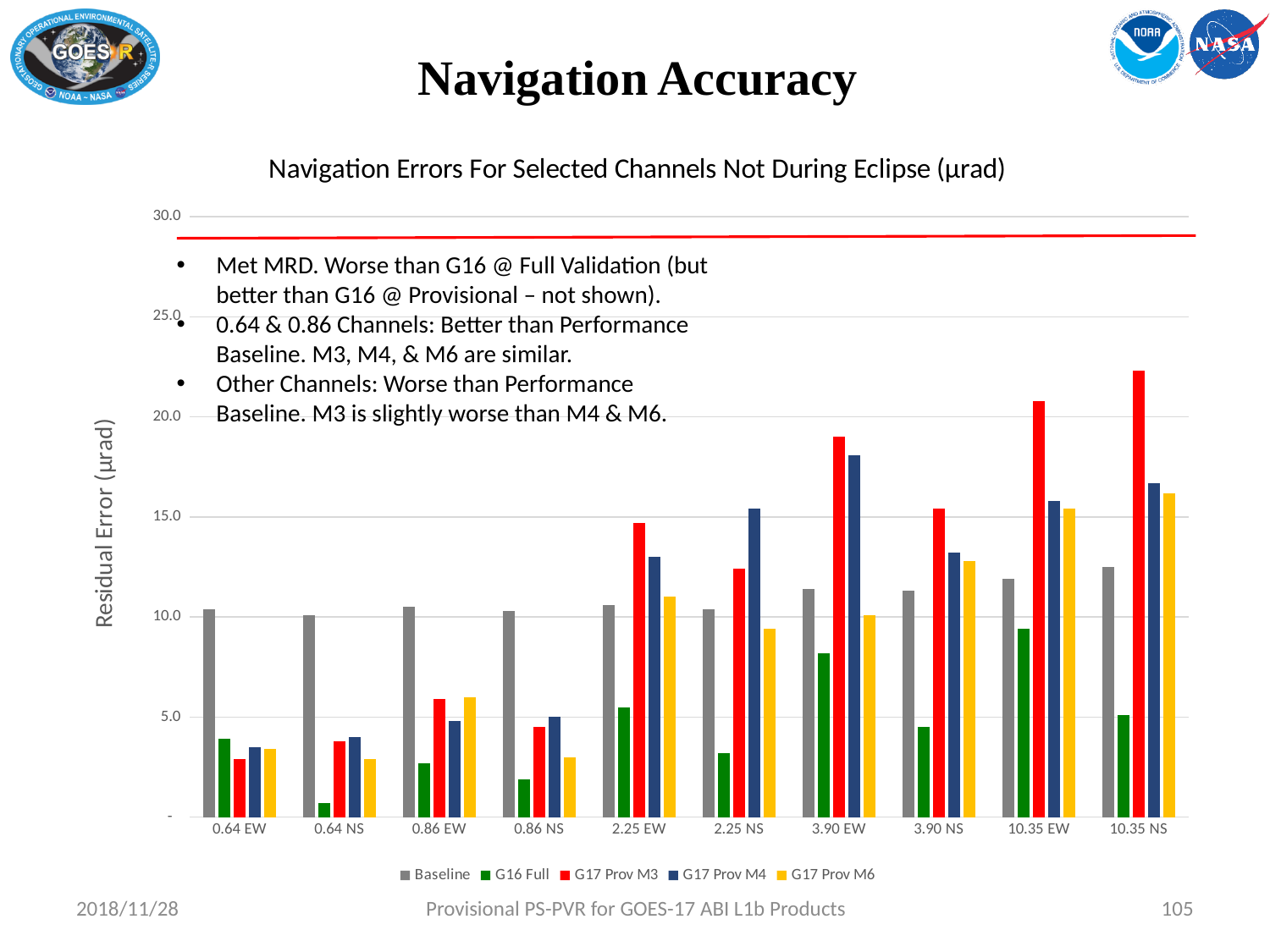
Which is larger for G17 Prov M3: the value for 10.35 NS or the value for 10.35 EW? 10.35 NS For which category is the G16 Full value lowest? 0.64 NS For which category is the G17 Prov M3 value highest? 10.35 NS How many series does the chart's legend list? 5 What is the title of the chart? Navigation Errors For Selected Channels Not During Eclipse (μrad) What is the label of the chart's y axis? Residual Error (μrad) Is the G16 Full value for 0.64 EW greater or less than 5.0? less Which is larger for 3.90 EW: the G17 Prov M3 value or the G16 Full value? G17 Prov M3 What kind of chart is shown on the slide? bar chart Is the G17 Prov M3 value for 3.90 EW greater or less than 15.0? greater Is the G17 Prov M3 value for 10.35 EW greater or less than 20.0? greater How many categories are shown along the x axis of the chart? 10